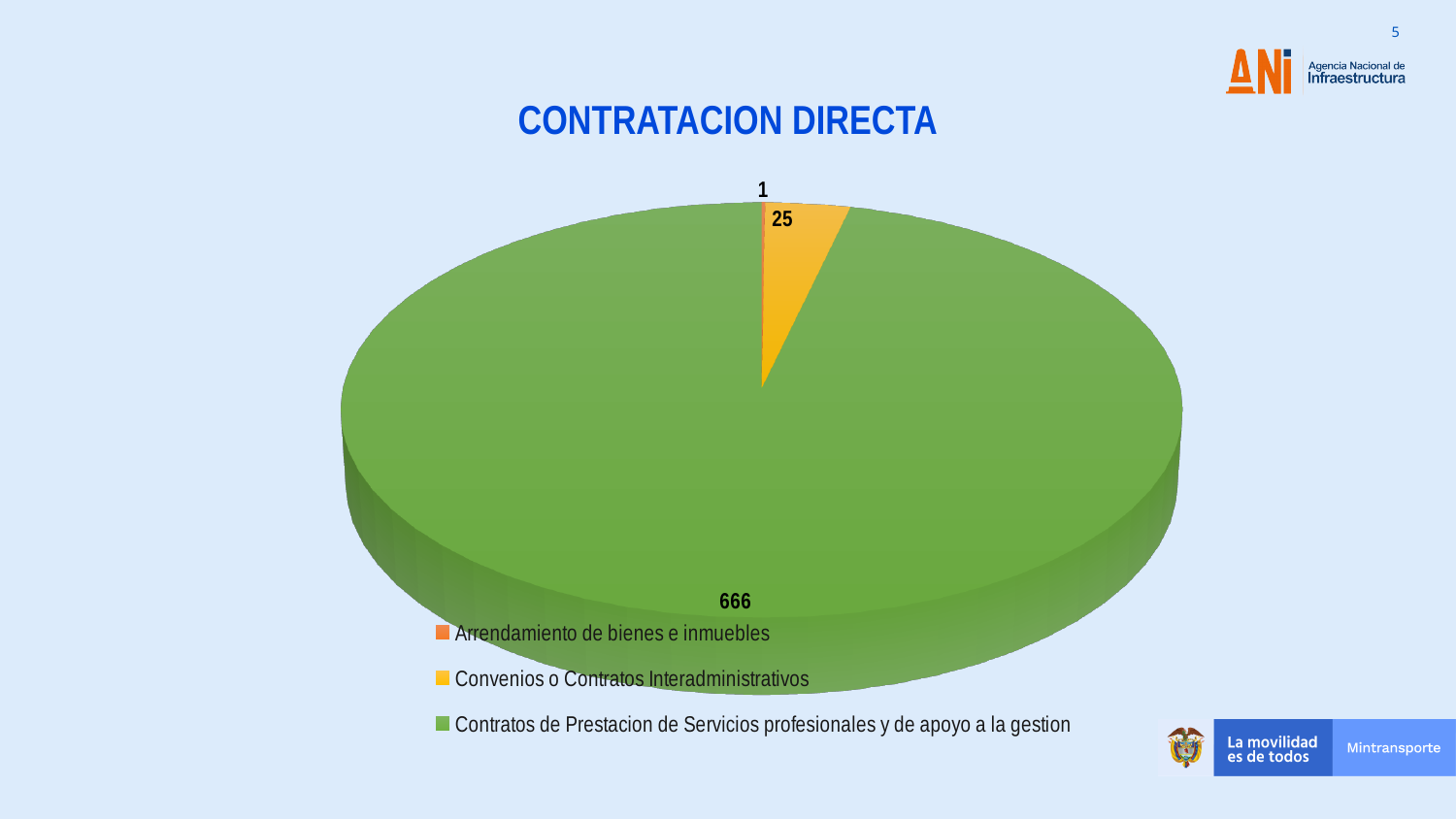
What is the value for Arrendamiento de bienes e inmuebles? 1 What is the total of all the slices in the pie chart? 692 Which category has the largest slice of the pie? Contratos de Prestacion de Servicios profesionales y de apoyo a la gestion What is the value for Convenios o Contratos Interadministrativos? 25 What is the difference between the value for Contratos de Prestacion de Servicios profesionales y de apoyo a la gestion and the value for Convenios o Contratos Interadministrativos? 641 What is the difference between the value for Convenios o Contratos Interadministrativos and the value for Arrendamiento de bienes e inmuebles? 24 What type of chart is shown on the slide? Pie chart Which is larger: the value for Convenios o Contratos Interadministrativos or the value for Arrendamiento de bienes e inmuebles? Convenios o Contratos Interadministrativos How many categories does the pie chart have? 3 What is the value for Contratos de Prestacion de Servicios profesionales y de apoyo a la gestion? 666 Which category has the smallest slice of the pie? Arrendamiento de bienes e inmuebles What is the title of the chart? CONTRATACION DIRECTA